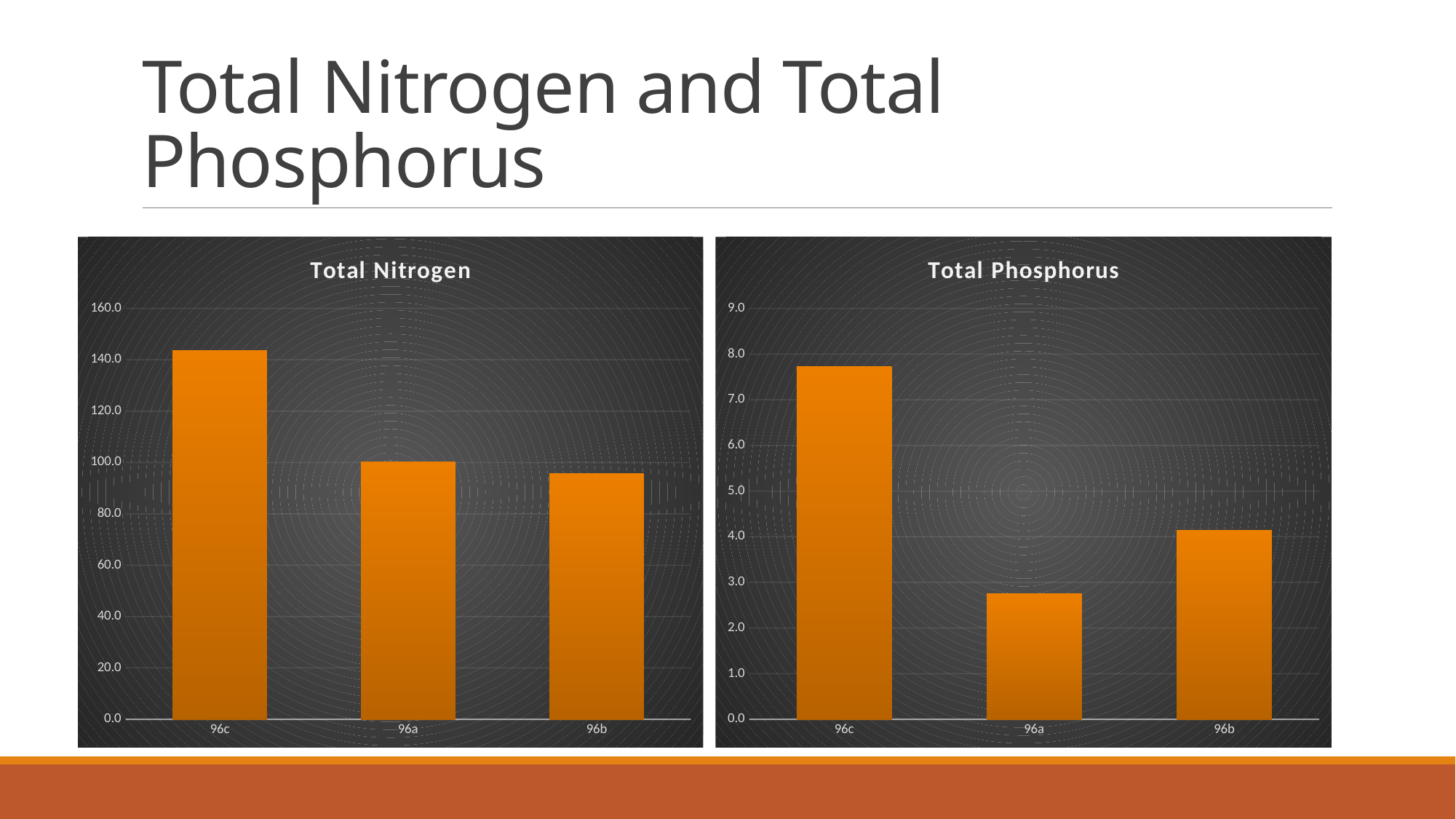
In the Total Phosphorus chart, which category has the lowest value? 96a How many categories are shown in the Total Phosphorus chart? 3 In the Total Nitrogen chart, is the value for 96c greater or less than 120.0? greater In the Total Phosphorus chart, is the value for 96a greater or less than 3.0? less What is the title of the chart on the right side of the slide? Total Phosphorus In the Total Phosphorus chart, which is larger, the value for 96b or the value for 96a? 96b In the Total Nitrogen chart, which category has the highest value? 96c In the Total Phosphorus chart, which category has the highest value? 96c In the Total Phosphorus chart, is the value for 96c greater or less than 7.0? greater What kind of chart is the Total Nitrogen chart? bar chart In the Total Nitrogen chart, which category has the lowest value? 96b